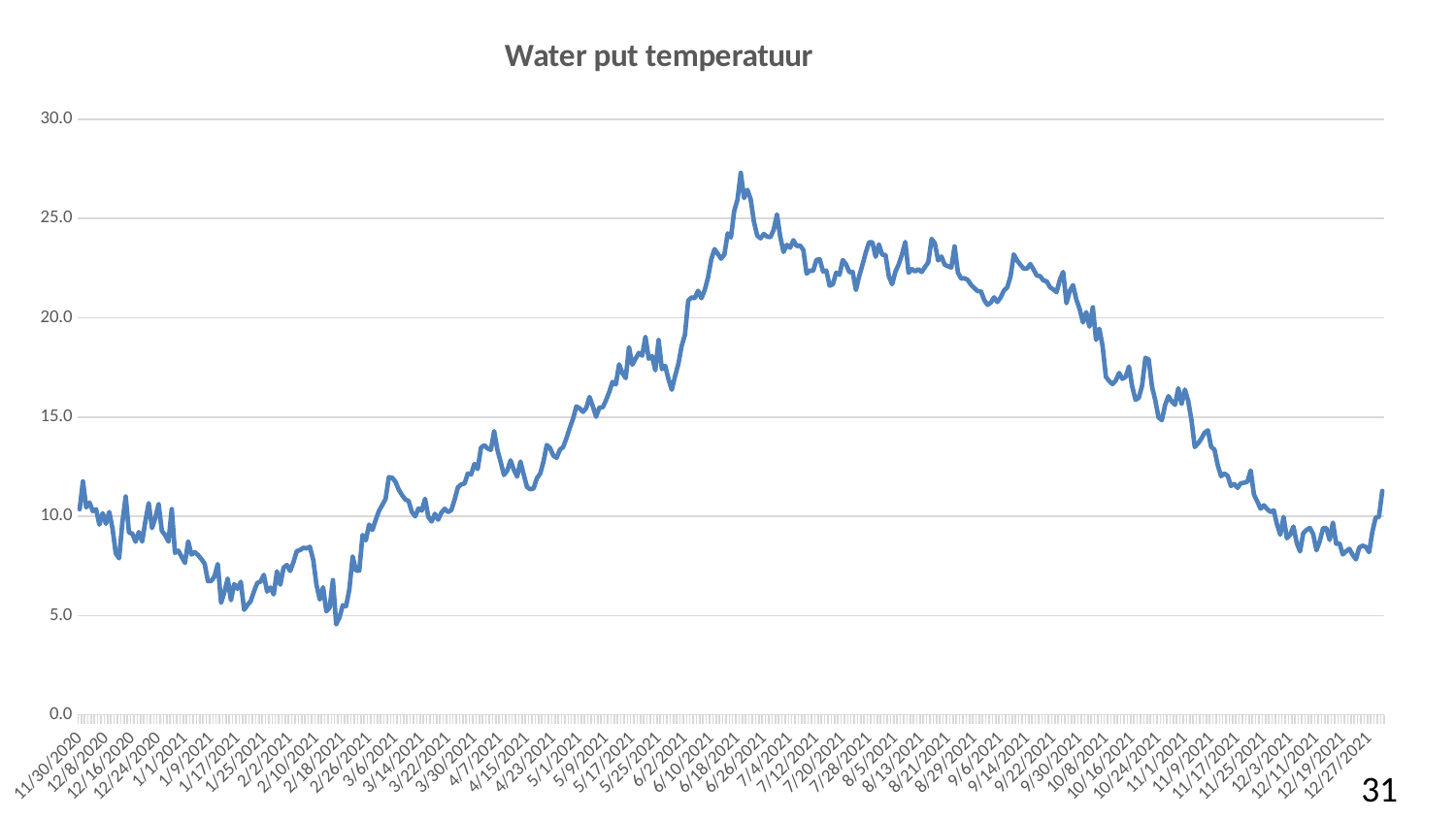
Is the value around 1/17/2021 greater or less than 10.0? less Is the value around 8/13/2021 greater or less than 20.0? greater Is the value around 7/4/2021 greater or less than 20.0? greater Does the line generally rise or fall between 9/22/2021 and 12/11/2021? fall How many data series are plotted on the chart? 1 Does the line generally rise or fall between 2/18/2021 and 6/18/2021? rise What is the title of the chart? Water put temperatuur What kind of chart is shown on the slide? line chart What is the highest value shown on the vertical axis? 30.0